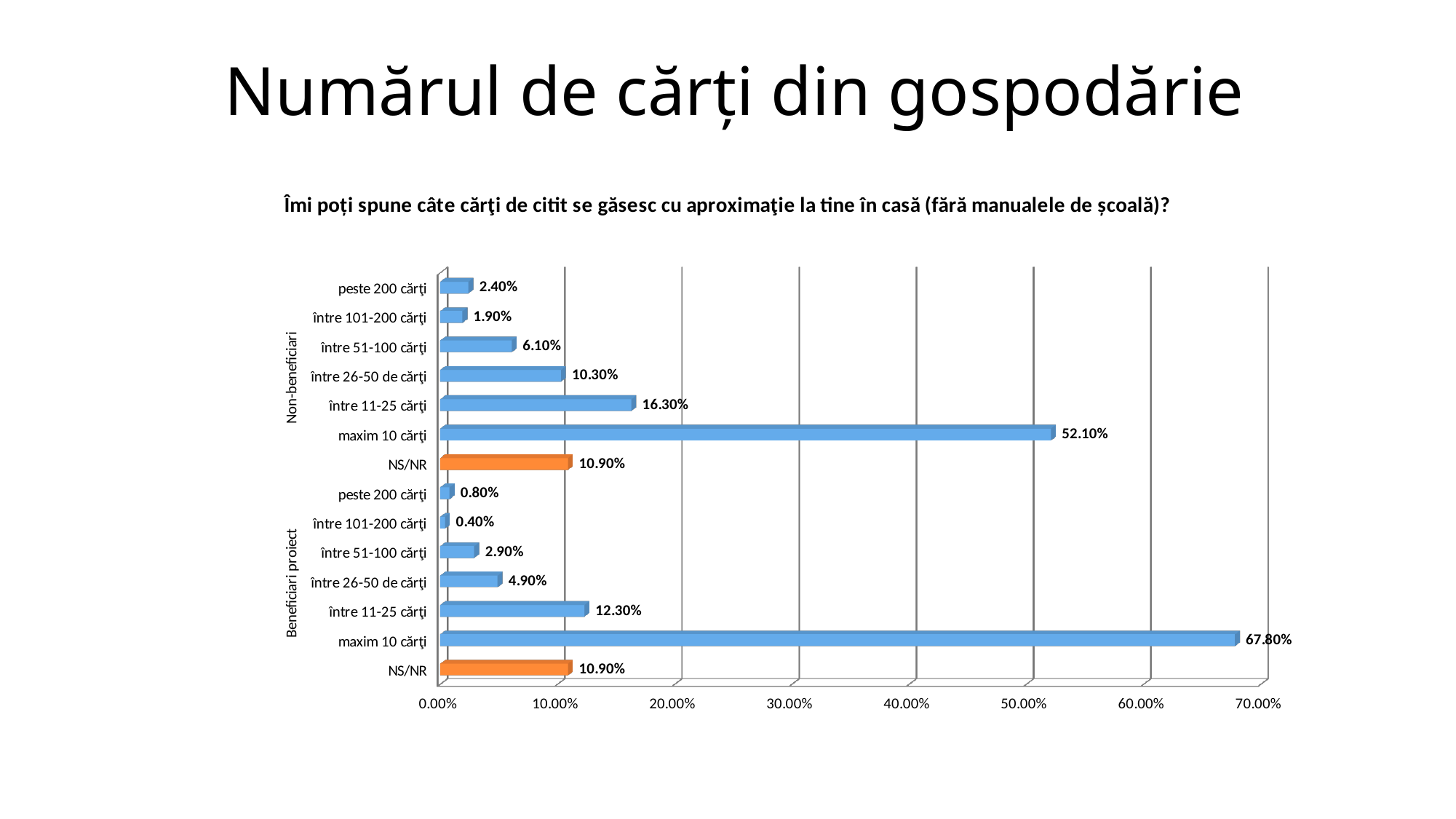
What is the value for 'între 11-25 cărți' in the Non-beneficiari group? 16.30% What kind of chart is shown on the slide? bar chart Which category has the lowest value in the Beneficiari proiect group? între 101-200 cărți How many bars are plotted in the chart in total? 14 Which category has the highest value in the Non-beneficiari group? maxim 10 cărți What is the value for 'între 101-200 cărți' in the Beneficiari proiect group? 0.40% Which is larger: 'între 26-50 de cărți' for Non-beneficiari or 'între 26-50 de cărți' for Beneficiari proiect? Non-beneficiari Is the value for 'maxim 10 cărți' in the Non-beneficiari group greater or less than 50.00%? greater What is the difference between 'maxim 10 cărți' for Beneficiari proiect and 'maxim 10 cărți' for Non-beneficiari? 15.70% What is the value for 'maxim 10 cărți' in the Beneficiari proiect group? 67.80% What colour are the NS/NR bars? orange What is the value for NS/NR in the Non-beneficiari group? 10.90%